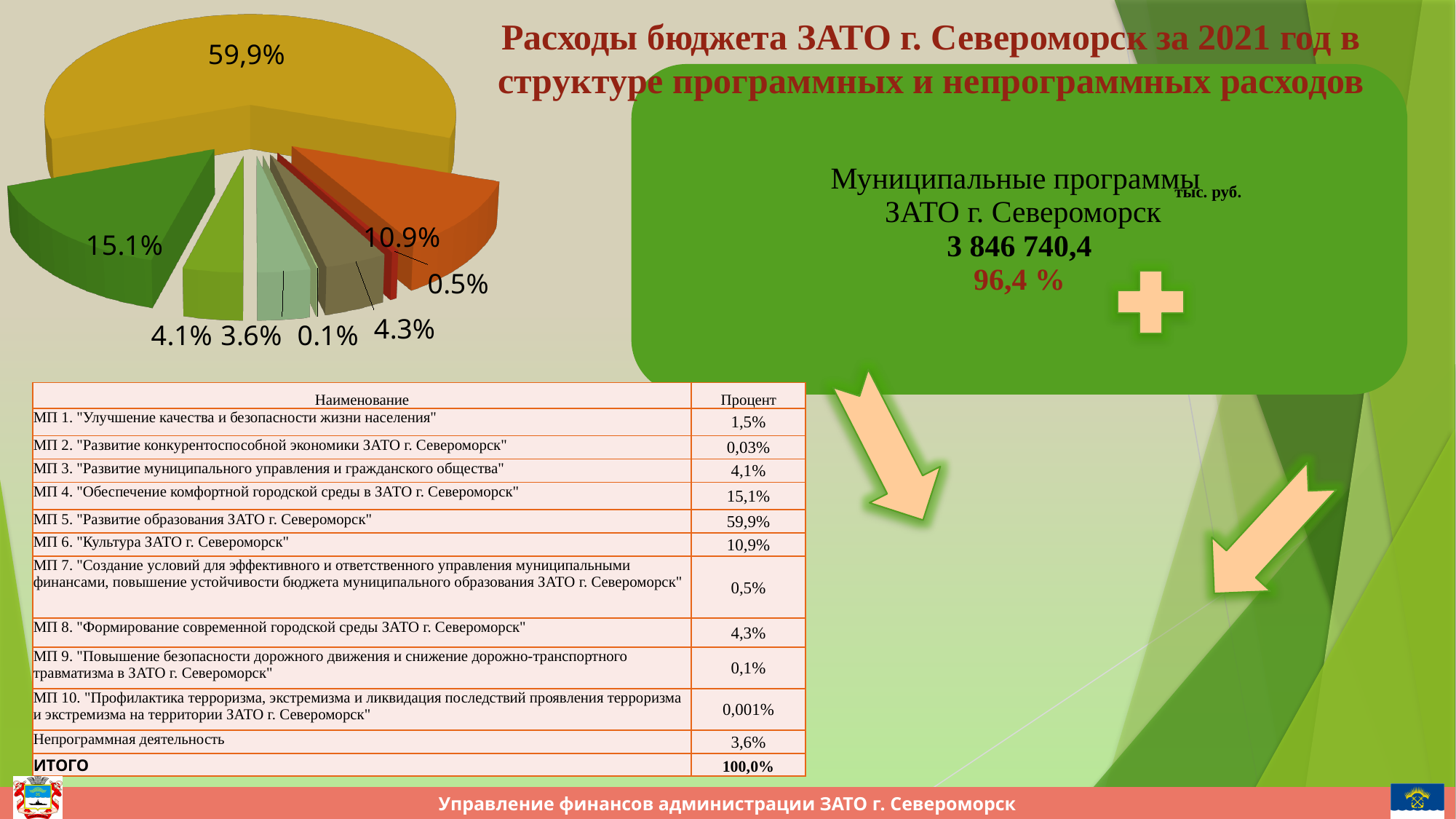
What is the difference between the slices labelled 4.3% and 4.1% on the pie chart? 0.2% What share of the pie does the largest (yellow) slice represent? 59,9% According to the table, which programme corresponds to the 59,9% slice of the pie chart? МП 5. "Развитие образования ЗАТО г. Североморск" What kind of chart is shown on the slide? pie chart What is the largest percentage labelled on the pie chart? 59,9% Is the largest slice of the pie chart greater or less than 50%? greater What is the difference between the slices labelled 15.1% and 10.9% on the pie chart? 4.2% What colour is the largest slice of the pie chart? yellow Which is larger on the pie chart: the slice labelled 15.1% or the slice labelled 10.9%? 15.1% What share of the pie does the orange slice represent? 10.9% What is the smallest percentage labelled on the pie chart? 0.1% According to the table, what percentage is shown for "Непрограммная деятельность"? 3,6%